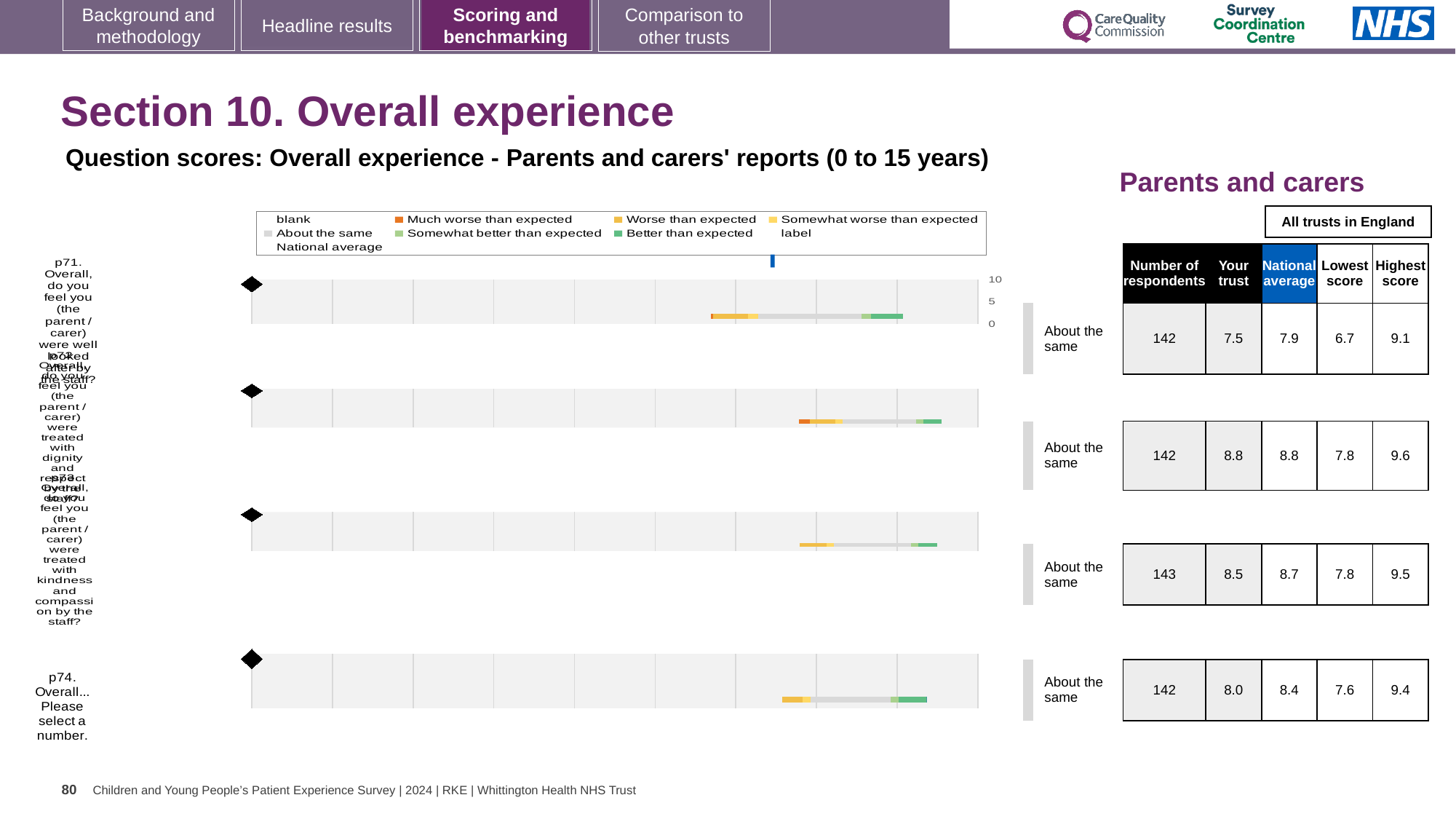
In the table, what is the Number of respondents for the third row? 143 Which row has the highest 'Your trust' score in the table? the second row (8.8) Which row has the lowest 'Your trust' score in the table? the first row, p71 (7.5) What kind of chart is used to show the question scores on this slide? bar chart In the table, what is the 'Your trust' score for the fourth row (p74. Overall... Please select a number)? 8.0 In the table, what is the Highest score for the second row? 9.6 For the third row, which is larger: the 'Your trust' score or the National average? National average What benchmark category label is shown next to each of the four bars? About the same For the first row (p71), what is the difference between the National average and the 'Your trust' score? 0.4 How many question rows (bars) are plotted in the chart? 4 What is the title of the chart? Question scores: Overall experience - Parents and carers' reports (0 to 15 years) In the table, what is the National average for the first row (p71)? 7.9